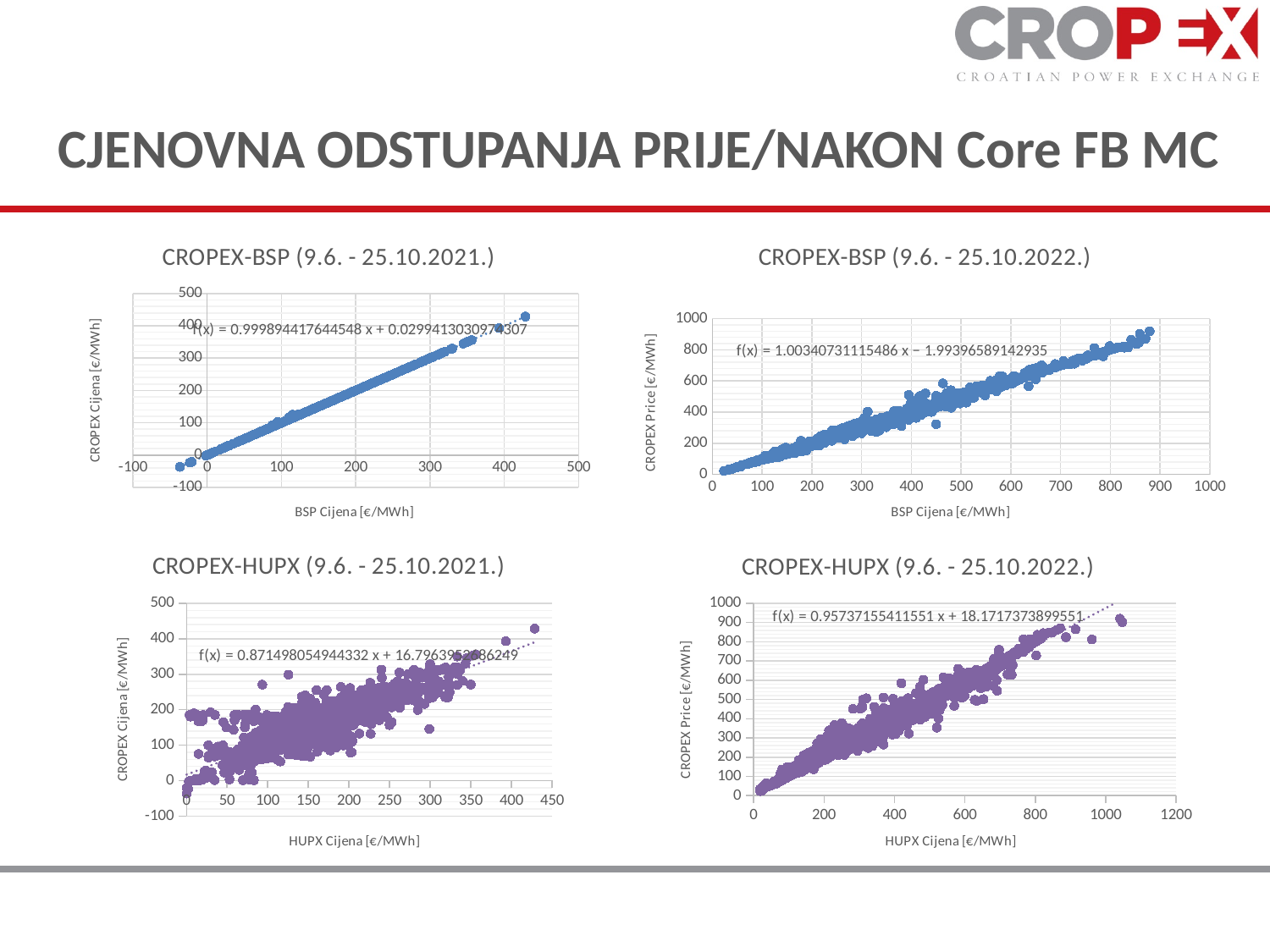
What is the maximum value shown on the x axis of the CROPEX-HUPX (9.6. - 25.10.2022.) chart? 1200 What is the y-axis label of the CROPEX-BSP (9.6. - 25.10.2022.) chart? CROPEX Price [€/MWh] What kind of chart is the CROPEX-BSP (9.6. - 25.10.2021.) chart? scatter chart What is the slope of the trendline equation shown in the CROPEX-HUPX (9.6. - 25.10.2021.) chart? 0.871498054944332 In the CROPEX-BSP (9.6. - 25.10.2022.) chart, is the highest CROPEX price plotted greater or less than 800? greater What is the slope of the trendline equation shown in the CROPEX-BSP (9.6. - 25.10.2022.) chart? 1.00340731115486 In the CROPEX-HUPX (9.6. - 25.10.2021.) chart, is the highest HUPX price plotted greater or less than 400? greater Which chart has the larger trendline slope, CROPEX-HUPX (9.6. - 25.10.2021.) or CROPEX-HUPX (9.6. - 25.10.2022.)? CROPEX-HUPX (9.6. - 25.10.2022.) In the CROPEX-HUPX (9.6. - 25.10.2022.) chart, do CROPEX prices rise or fall as the HUPX price increases? rise In the CROPEX-BSP (9.6. - 25.10.2021.) chart, is the lowest CROPEX price plotted greater or less than 0? less How many charts are shown on the slide? 4 What is the intercept of the trendline equation shown in the CROPEX-HUPX (9.6. - 25.10.2022.) chart? 18.1717373899551